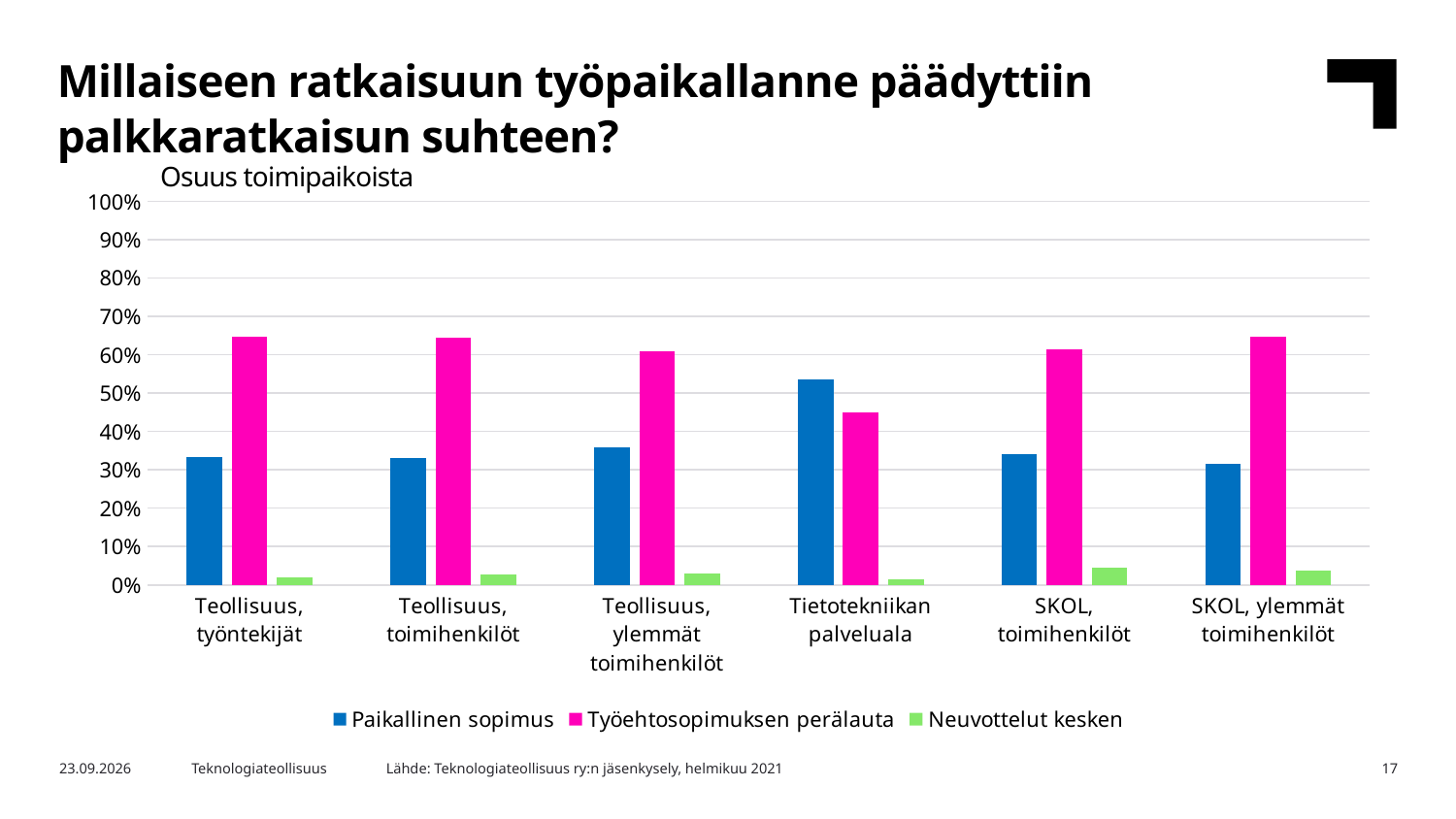
Is the value for Neuvottelut kesken in SKOL, toimihenkilöt greater or less than 10%? less Is the value for Työehtosopimuksen perälauta in Tietotekniikan palveluala greater or less than 50%? less Is the value for Työehtosopimuksen perälauta in Teollisuus, työntekijät greater or less than 60%? greater What kind of chart is shown on the slide? Bar chart How many categories are shown on the x axis of the chart? 6 How many series does the chart's legend list? 3 In Teollisuus, työntekijät, which is larger: Paikallinen sopimus or Työehtosopimuksen perälauta? Työehtosopimuksen perälauta In Tietotekniikan palveluala, which is larger: Paikallinen sopimus or Työehtosopimuksen perälauta? Paikallinen sopimus Which category has the highest value for Paikallinen sopimus? Tietotekniikan palveluala What is the label shown above the vertical axis of the chart? Osuus toimipaikoista Which category has the lowest value for Työehtosopimuksen perälauta? Tietotekniikan palveluala